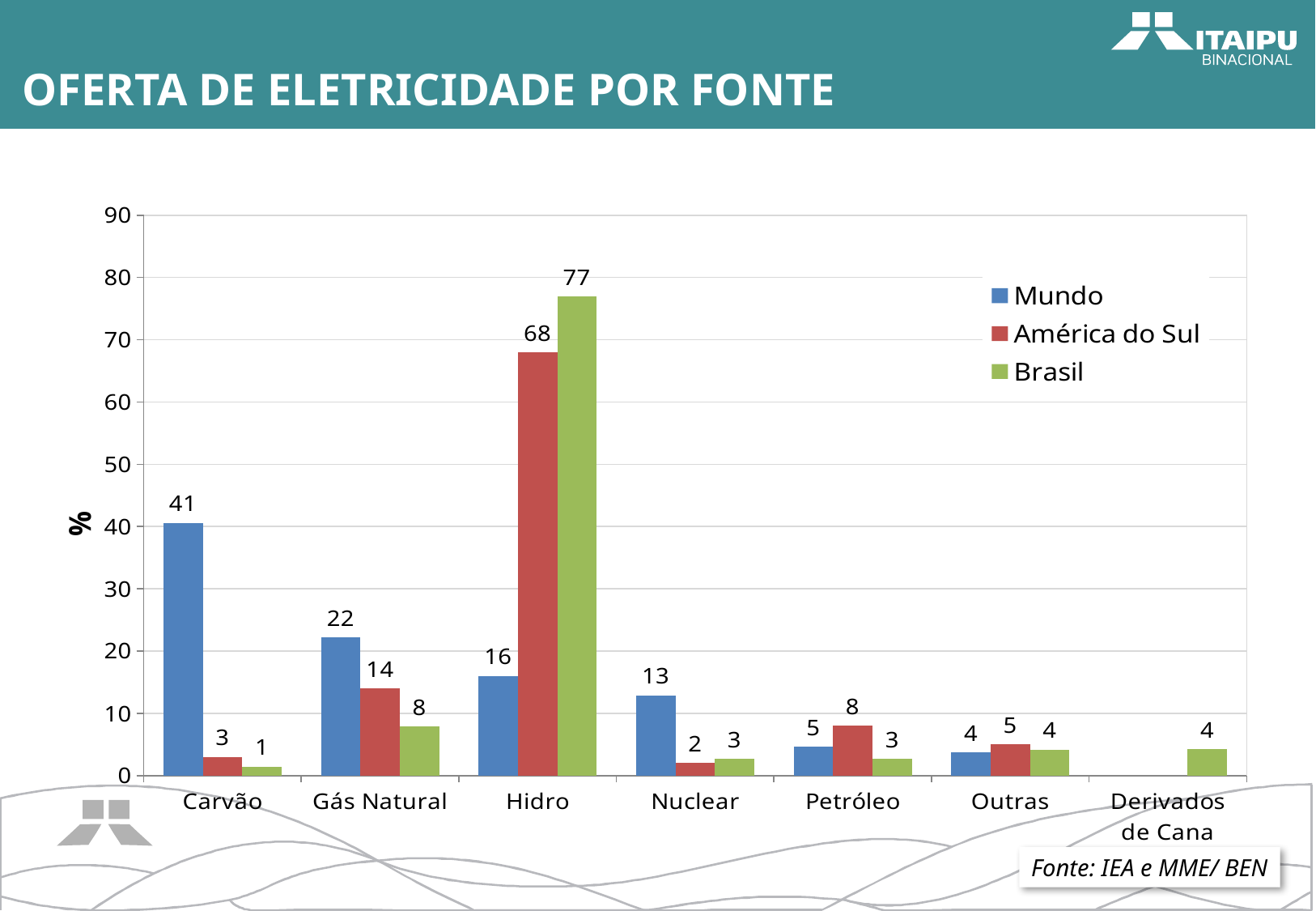
How many categories are shown on the x axis? 7 Which category has the highest value for the Mundo series? Carvão What is the difference between the Brasil and América do Sul values for Hidro? 9 What is the value for América do Sul in the Gás Natural category? 14 Which is larger for Nuclear: the Mundo value or the Brasil value? Mundo What is the value for Mundo in the Carvão category? 41 What is the label on the vertical axis? % What is the value for Brasil in the Hidro category? 77 What kind of chart is shown on the slide? bar chart How many series does the legend list? 3 Is the value for América do Sul in Hidro greater or less than 60? greater Which category has the lowest value for the Brasil series? Carvão